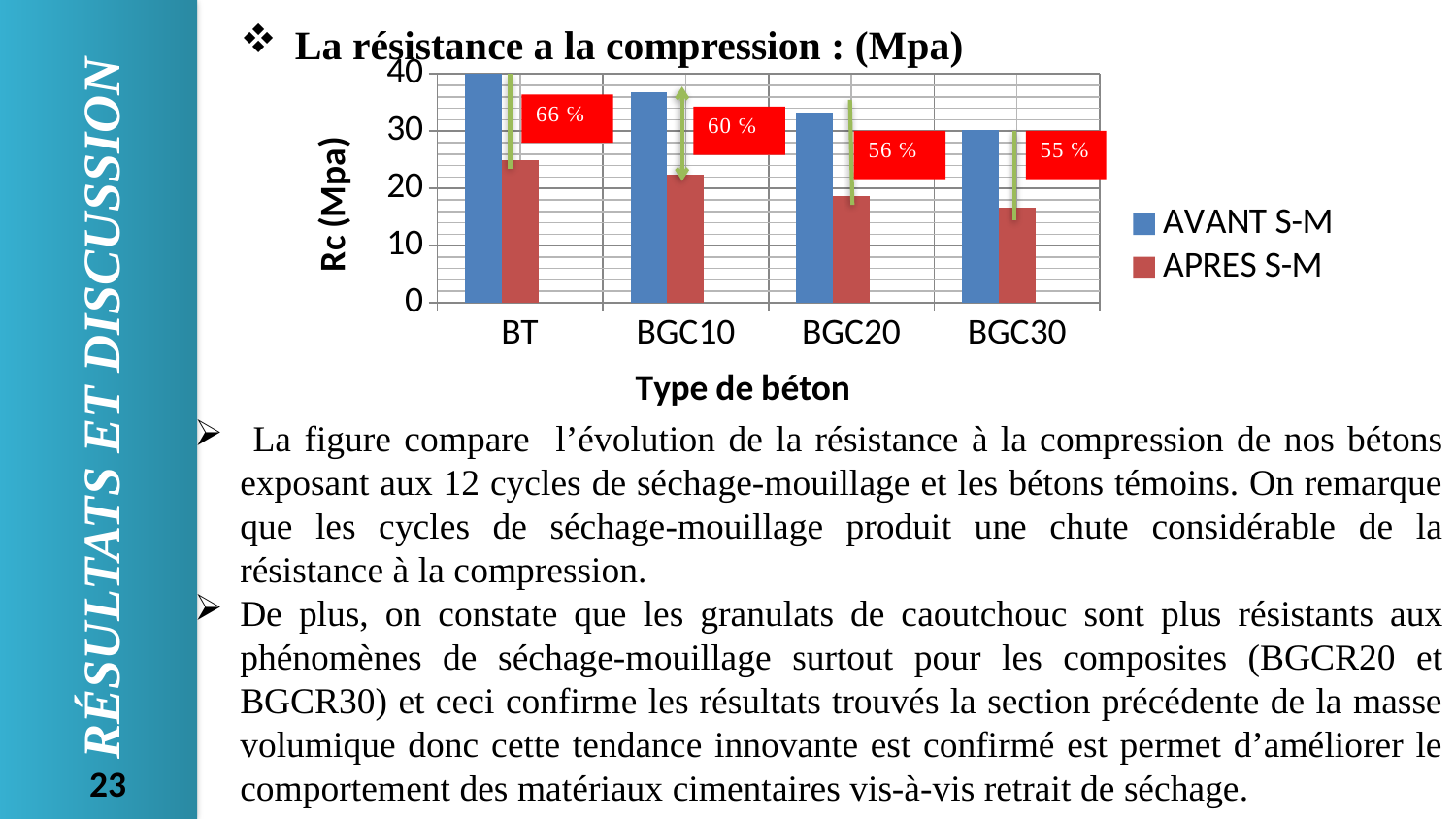
Is the APRES S-M value for BGC20 greater or less than 20? less Which category has the lowest APRES S-M value? BGC30 Which category has the highest AVANT S-M value? BT What is the title of the x axis? Type de béton Is the APRES S-M value for BT greater or less than 20? greater Do the AVANT S-M values rise or fall from BT to BGC30 along the x axis? fall How many series does the legend list? 2 What kind of chart is shown on the slide? bar chart Which category has the lowest AVANT S-M value? BGC30 How many types of concrete (categories) are shown on the x axis? 4 Which is larger, the AVANT S-M value for BT or the AVANT S-M value for BGC20? BT Is the AVANT S-M value for BGC10 greater or less than 30? greater